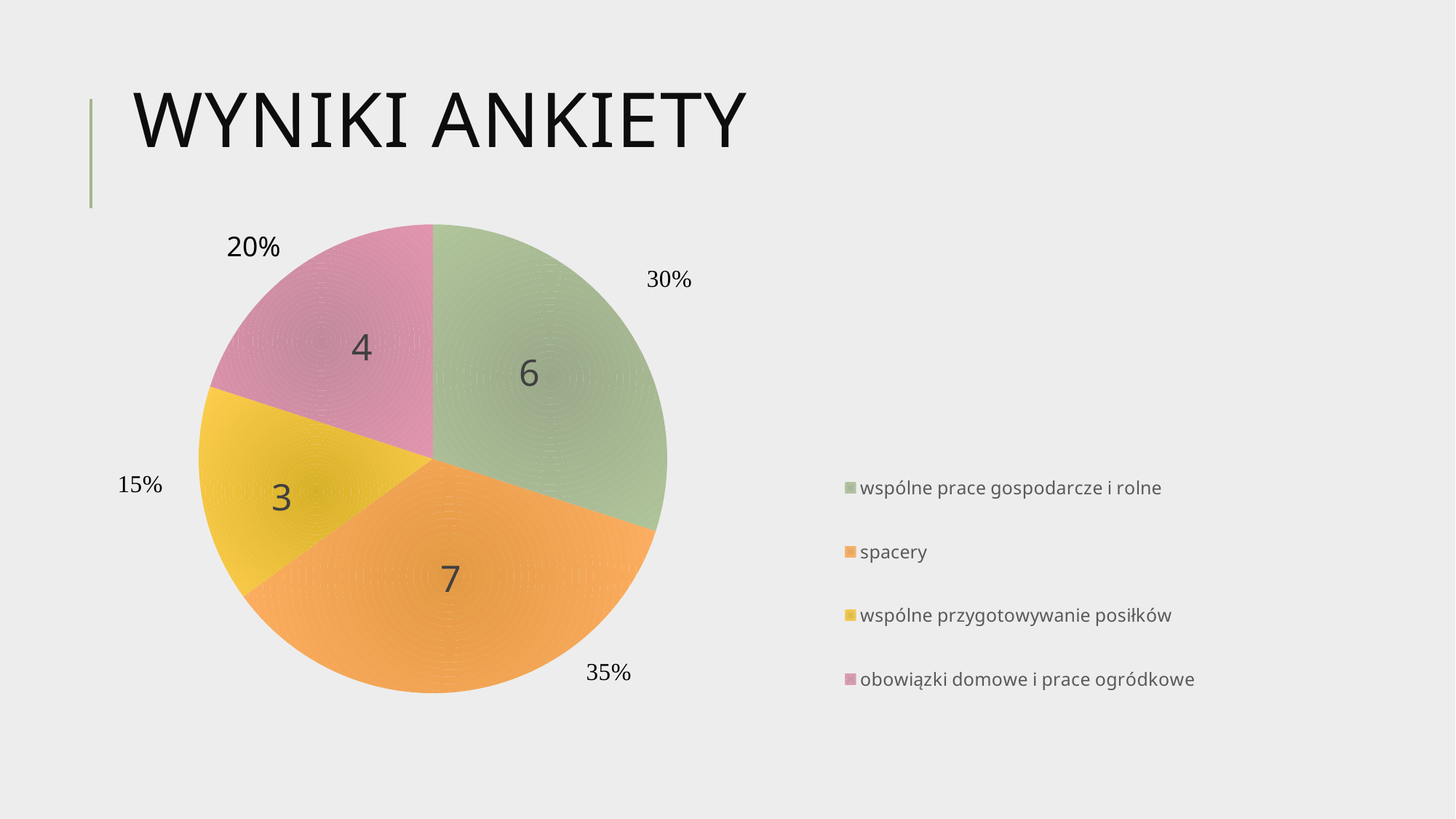
Which category has the smallest slice? wspólne przygotowywanie posiłków What is the value for spacery? 7 Which is larger, the value for wspólne prace gospodarcze i rolne or the value for obowiązki domowe i prace ogródkowe? wspólne prace gospodarcze i rolne What share of the pie does wspólne przygotowywanie posiłków represent? 15% What is the value for wspólne przygotowywanie posiłków? 3 What is the value for obowiązki domowe i prace ogródkowe? 4 What kind of chart is shown on the slide? pie chart What is the value for wspólne prace gospodarcze i rolne? 6 What is the difference between the values for spacery and obowiązki domowe i prace ogródkowe? 3 How many categories does the legend list? 4 Which category has the largest slice? spacery What share of the pie does spacery represent? 35%